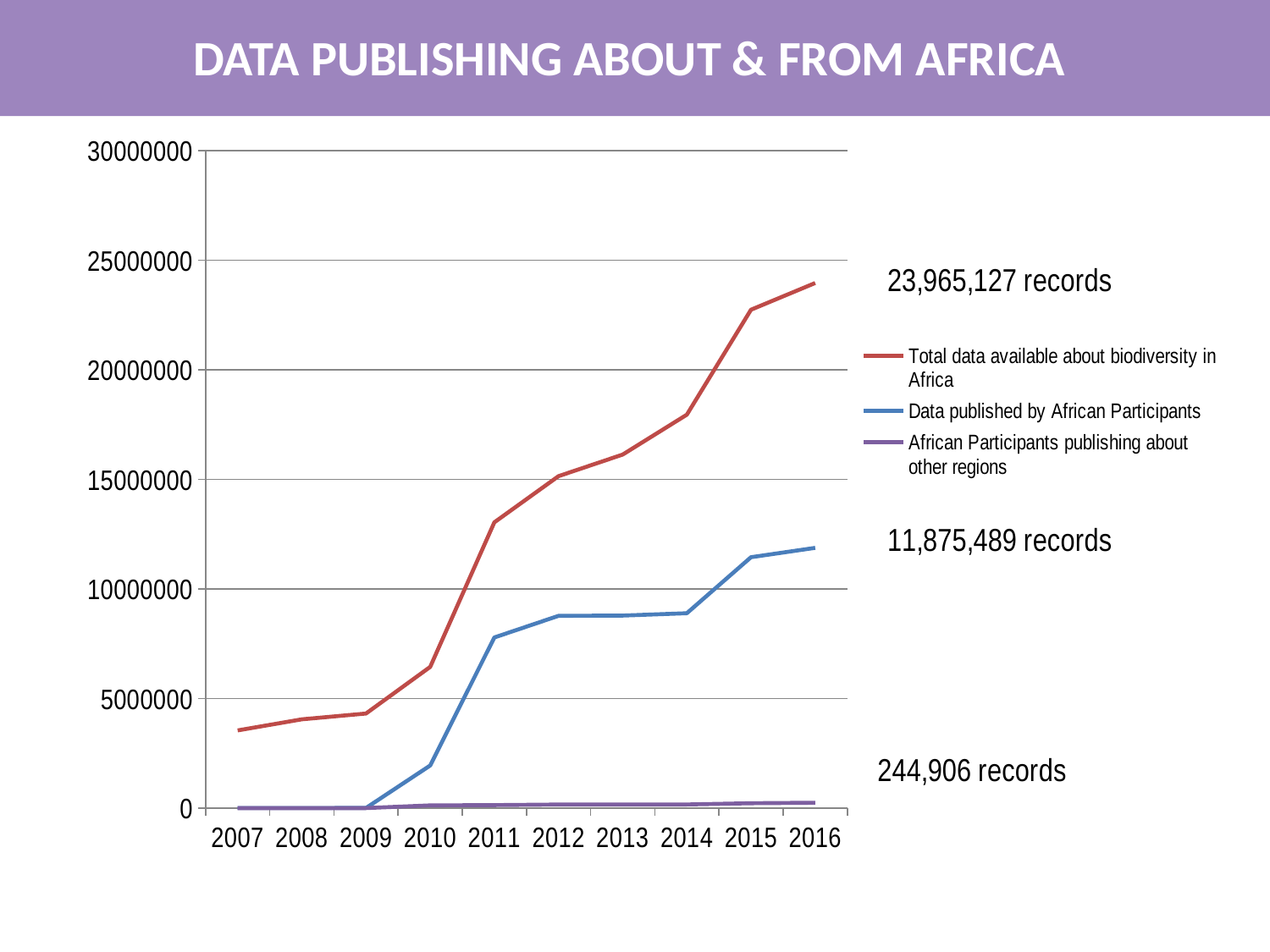
Is the value for Total data available about biodiversity in Africa in 2011 greater or less than 10000000? greater Which series has the lowest values across the chart? African Participants publishing about other regions How many years are shown on the x axis? 10 Does the Total data available about biodiversity in Africa line rise or fall from 2007 to 2016? rise How many records are shown for Data published by African Participants in 2016? 11,875,489 records How many records are shown for African Participants publishing about other regions in 2016? 244,906 records Is the value for Data published by African Participants in 2010 greater or less than 5000000? less Which series has the highest value in 2016? Total data available about biodiversity in Africa How many records are shown for Total data available about biodiversity in Africa in 2016? 23,965,127 records What kind of chart is shown on the slide? line chart How many series does the legend list? 3 What is the title of the slide? DATA PUBLISHING ABOUT & FROM AFRICA